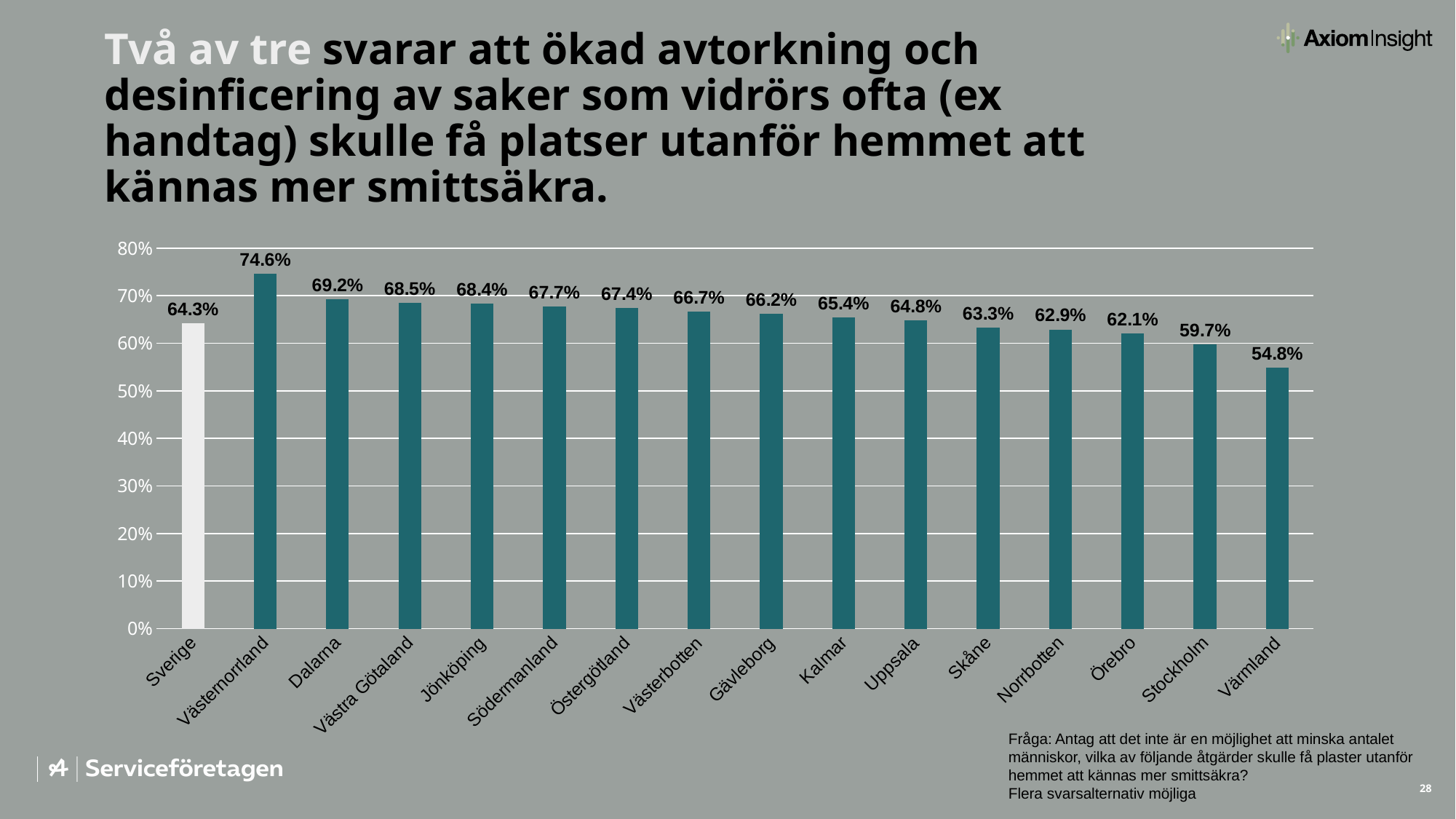
Do the values for the regions (excluding Sverige) rise or fall from left to right? fall What is the difference between Västernorrland and Värmland? 19.8% How many bars are shown in the chart? 16 What kind of chart is shown on the slide? bar chart Which region has the highest value? Västernorrland Is the value for Värmland greater or less than 60%? less Which bar is shown in a different colour (white) from the others? Sverige What is the value for Sverige? 64.3% Which region has the lowest value? Värmland Which is larger, the value for Skåne or the value for Örebro? Skåne What is the value for Dalarna? 69.2% What is the value for Stockholm? 59.7%